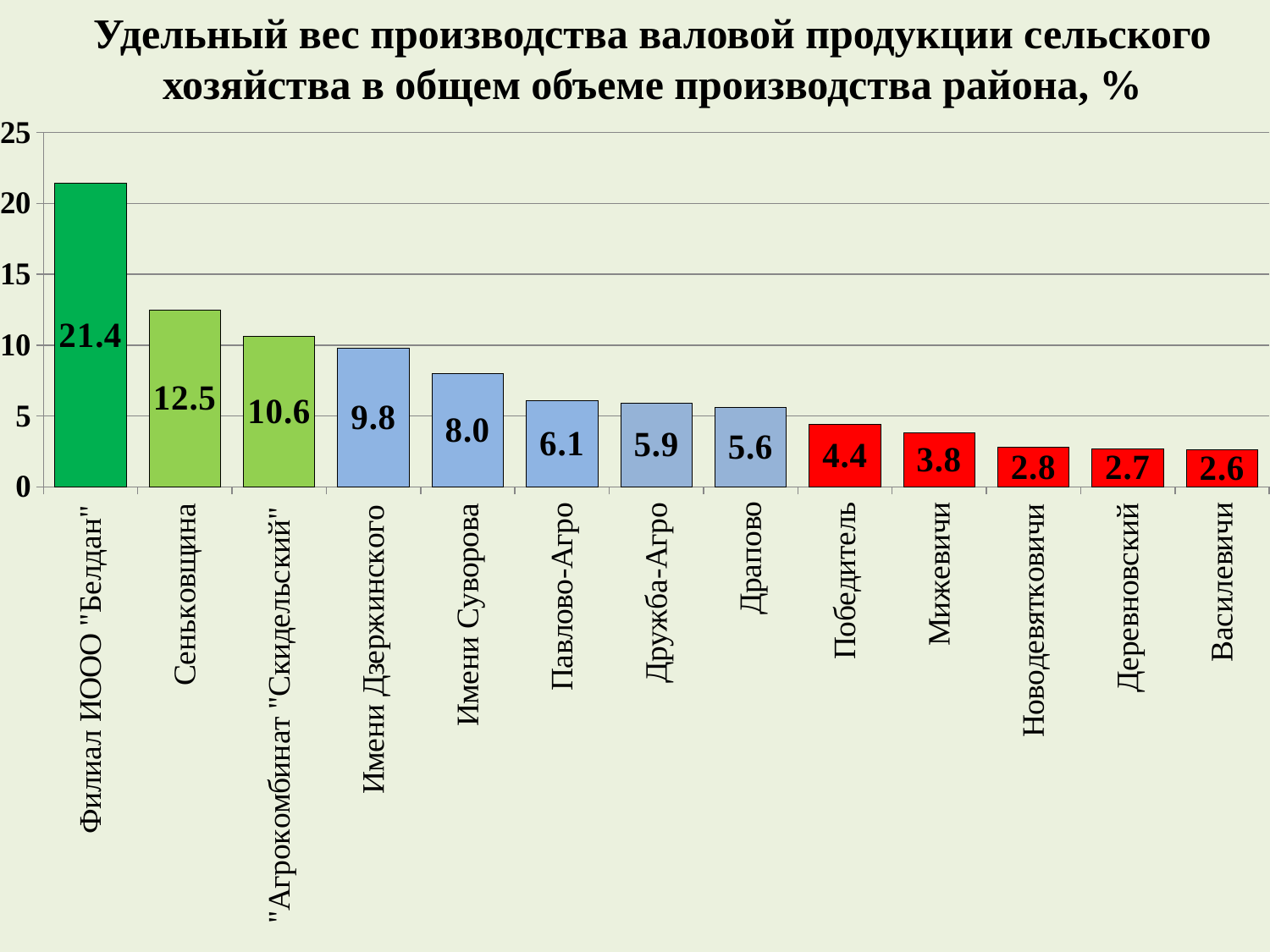
Which category has the lowest value? Василевичи Which is larger, the value for Павлово-Агро or the value for Победитель? Павлово-Агро What is the value for Имени Суворова? 8.0 What kind of chart is shown on the slide? bar chart Do the values rise or fall from left to right along the x axis? fall Is the value for Агрокомбинат "Скидельский" greater or less than 10? greater How many categories are shown on the chart? 13 What is the value for Сеньковщина? 12.5 What is the difference between the values for Имени Дзержинского and Драпово? 4.2 What is the value for Мижевичи? 3.8 Which category has the highest value? Филиал ИООО "Белдан" What is the difference between the values for Филиал ИООО "Белдан" and Сеньковщина? 8.9